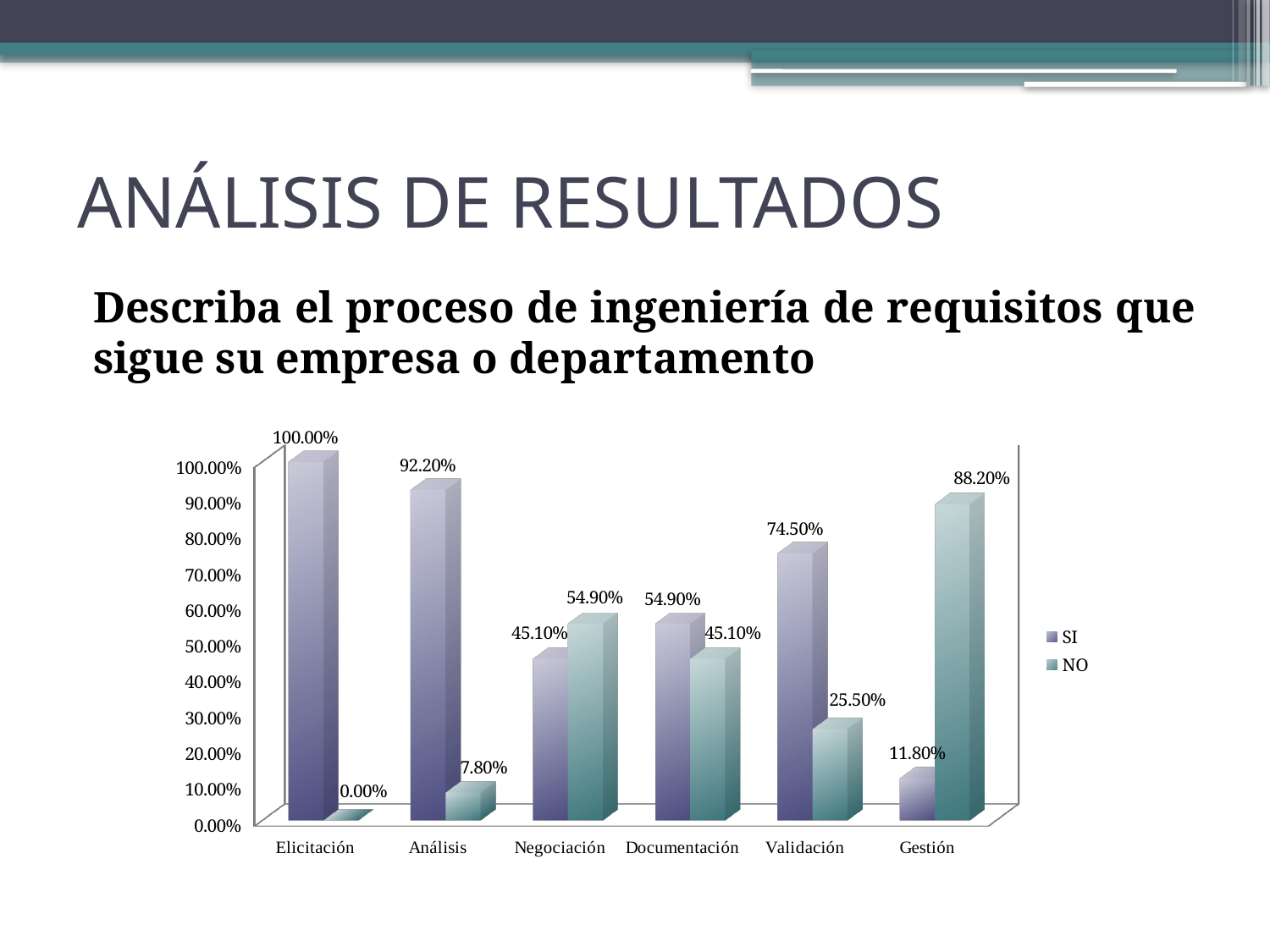
What kind of chart is shown on the slide? Bar chart Which is larger for Negociación, the SI value or the NO value? NO What is the SI value for Validación? 74.50% How many series does the legend list? 2 How many categories are shown on the x axis? 6 What is the NO value for Gestión? 88.20% What is the SI value for Elicitación? 100.00% Which category has the highest SI value? Elicitación What is the difference between the SI and NO values for Validación? 49.00% Which category has the lowest NO value? Elicitación What is the NO value for Análisis? 7.80% What are the two series named in the legend? SI and NO